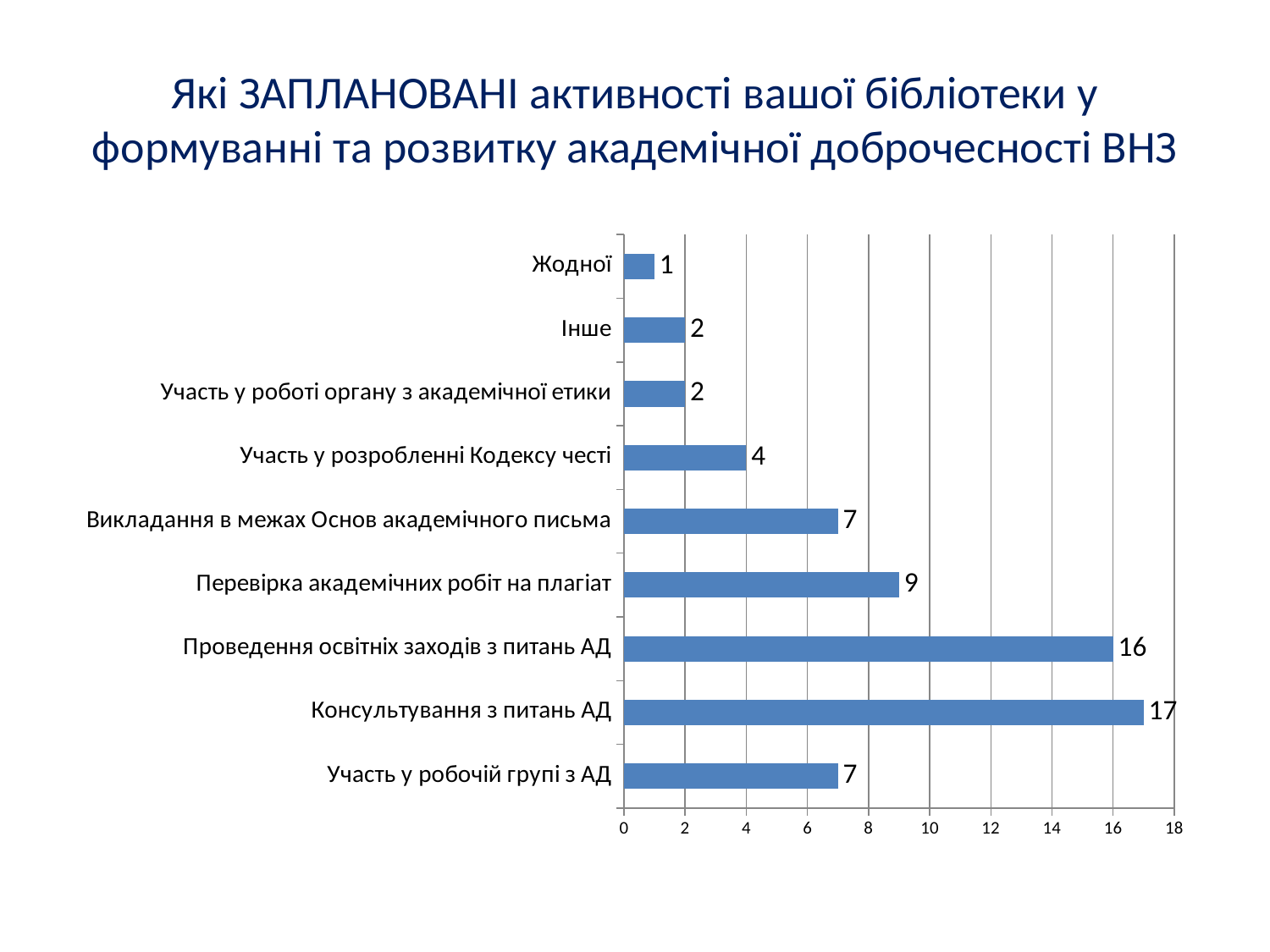
Which is larger: the value for "Викладання в межах Основ академічного письма" or the value for "Участь у розробленні Кодексу честі"? Викладання в межах Основ академічного письма What is the value for "Участь у розробленні Кодексу честі"? 4 What is the difference between the values for "Перевірка академічних робіт на плагіат" and "Участь у розробленні Кодексу честі"? 5 How many categories are shown in the chart? 9 What is the value for "Консультування з питань АД"? 17 What is the maximum value shown on the horizontal axis? 18 What is the value for "Перевірка академічних робіт на плагіат"? 9 Is the value for "Проведення освітніх заходів з питань АД" greater or less than 10? greater Which category has the highest value? Консультування з питань АД What is the difference between the values for "Консультування з питань АД" and "Проведення освітніх заходів з питань АД"? 1 What kind of chart is shown on the slide? bar chart Which category has the lowest value? Жодної